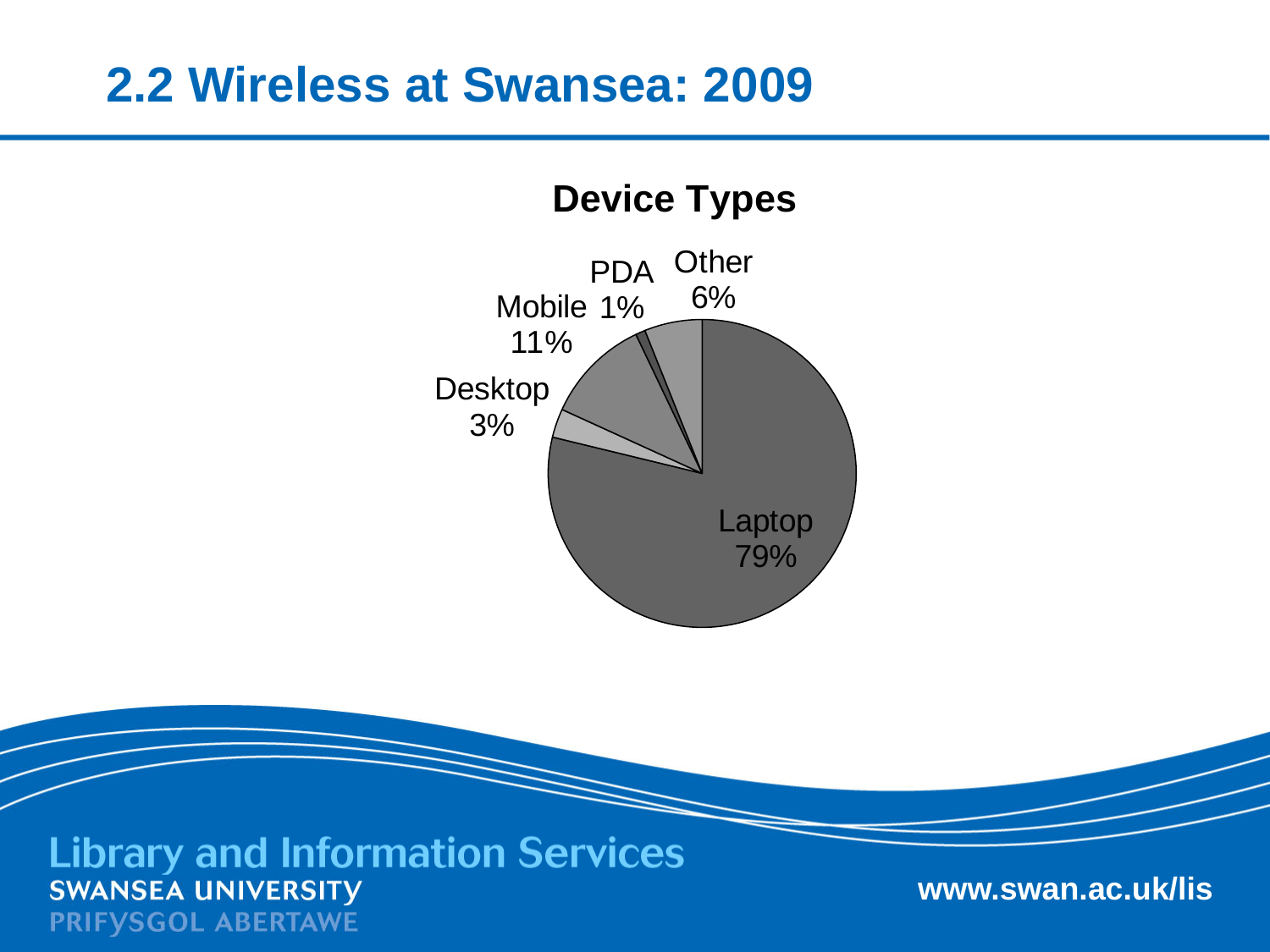
Which has a larger share, Other or Desktop? Other What percentage is shown for PDA? 1% What type of chart is shown on the slide? pie chart What is the title of the chart? Device Types Which device type has the smallest share of the pie? PDA What percentage is shown for Mobile? 11% Which device type has the largest share of the pie? Laptop What is the difference in percentage points between Laptop and Mobile? 68 How many device types are shown in the pie chart? 5 What percentage is shown for Other? 6% What percentage is shown for Desktop? 3% What share of the pie does Laptop account for? 79%